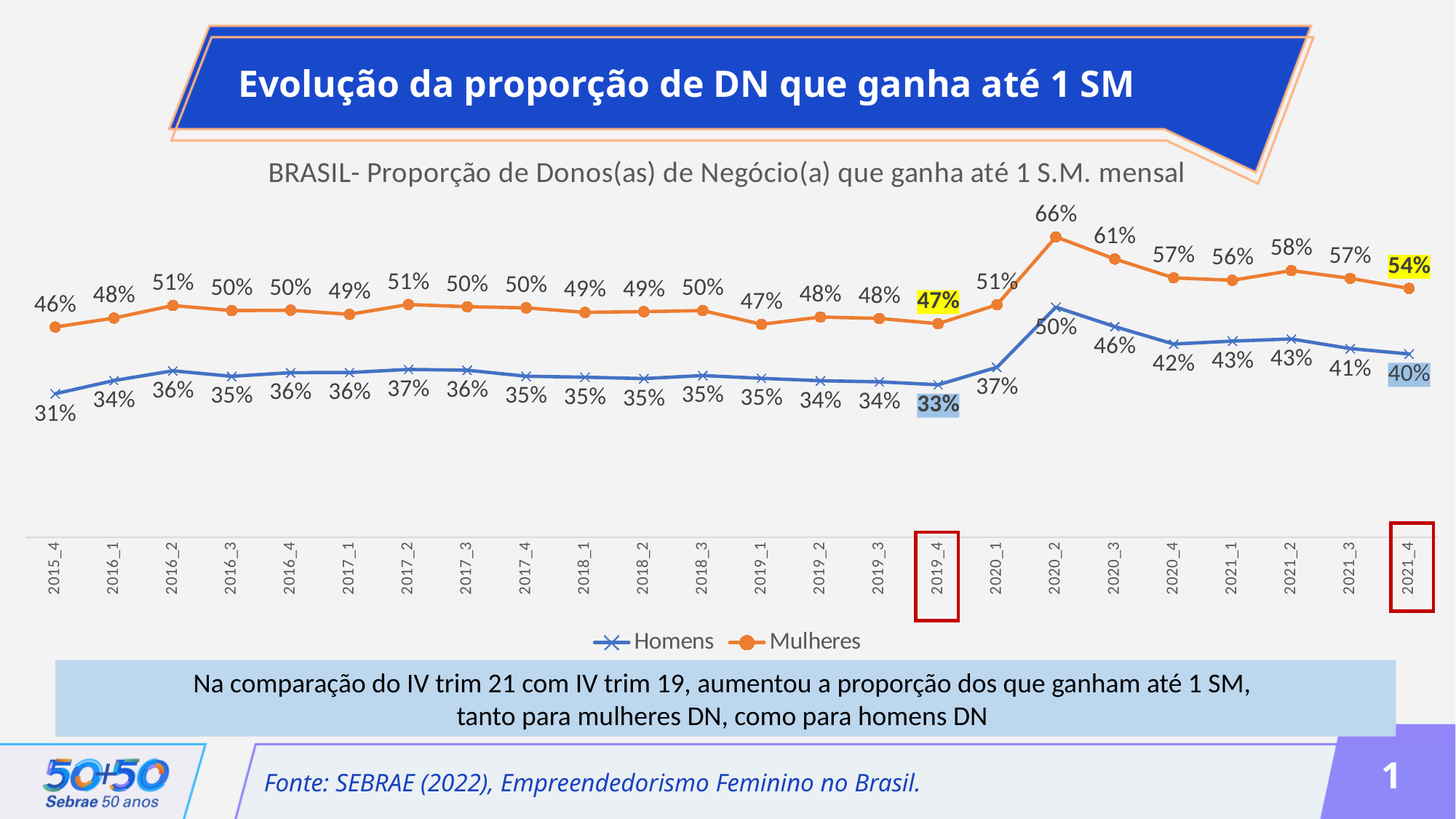
By how many percentage points did the Mulheres value change from 2019_4 to 2021_4? 7 percentage points In which quarter does the Homens series have its lowest value? 2015_4 Which is larger for Homens: the value in 2021_4 or the value in 2019_4? 2021_4 In which quarter does the Mulheres series reach its highest value? 2020_2 What is the value for Mulheres in 2021_4? 54% What kind of chart is shown? Line chart How many series does the legend list? 2 What is the value for Homens in 2019_4? 33% What is the value for Homens in 2020_2? 50% Does the Mulheres series rise or fall from 2020_2 to 2021_4? Fall How many quarters are plotted on the x axis? 24 What is the difference between the Mulheres and Homens values in 2020_2? 16 percentage points